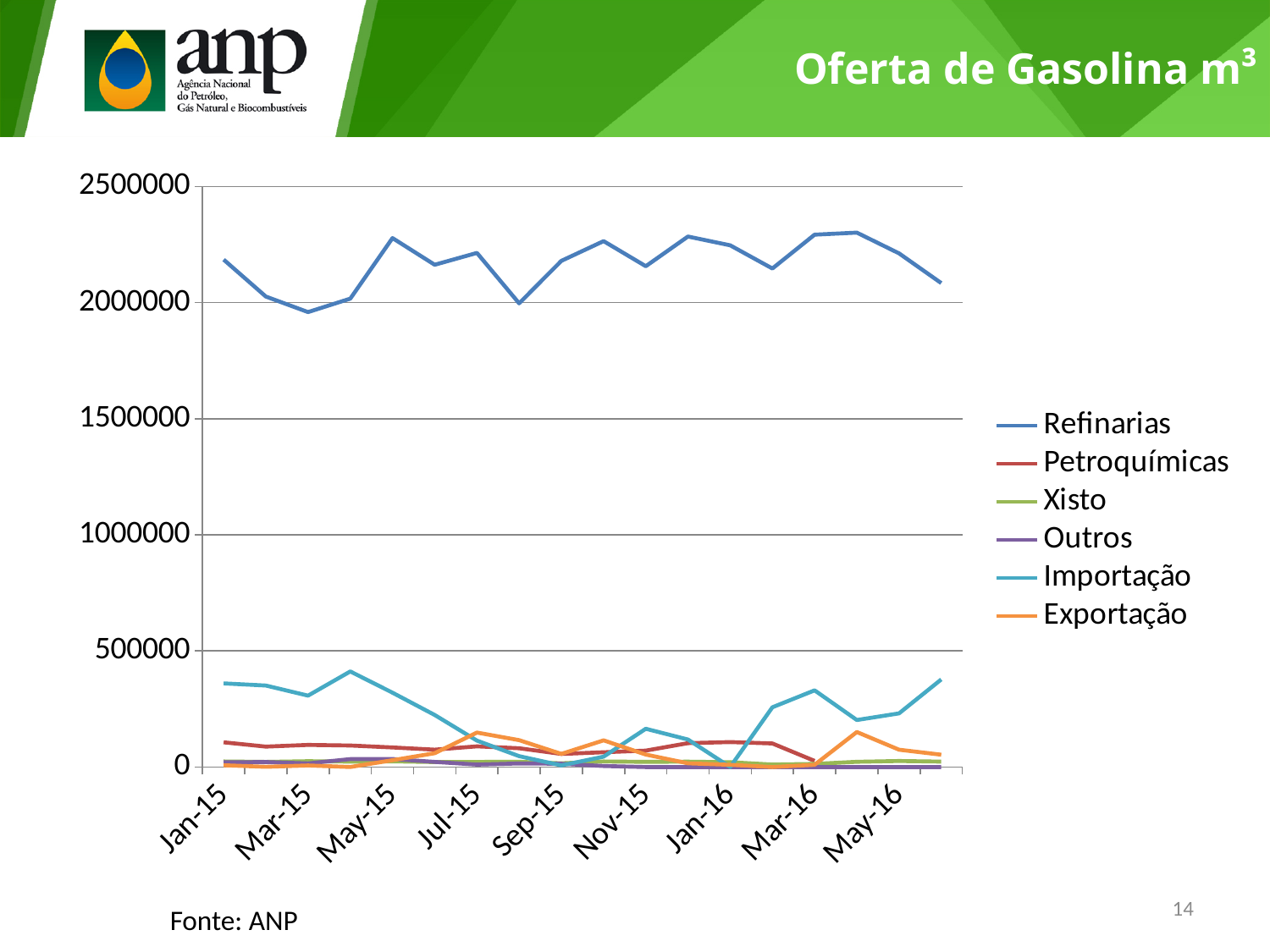
At Jan-15, which is larger: Refinarias or Petroquímicas? Refinarias What source is cited below the chart? Fonte: ANP Which series has the highest values throughout the chart? Refinarias Is the value for Importação at Jan-15 greater or less than 500000? less Is the value for Refinarias at Jan-16 greater or less than 2500000? less What is the title of the slide containing the chart? Oferta de Gasolina m³ Is the value for Refinarias at May-15 greater or less than 2000000? greater What kind of chart is shown on the slide? line chart How many series does the legend list? 6 Does the Importação line rise or fall from May-15 to Sep-15? fall At Jan-15, which is larger: Importação or Exportação? Importação